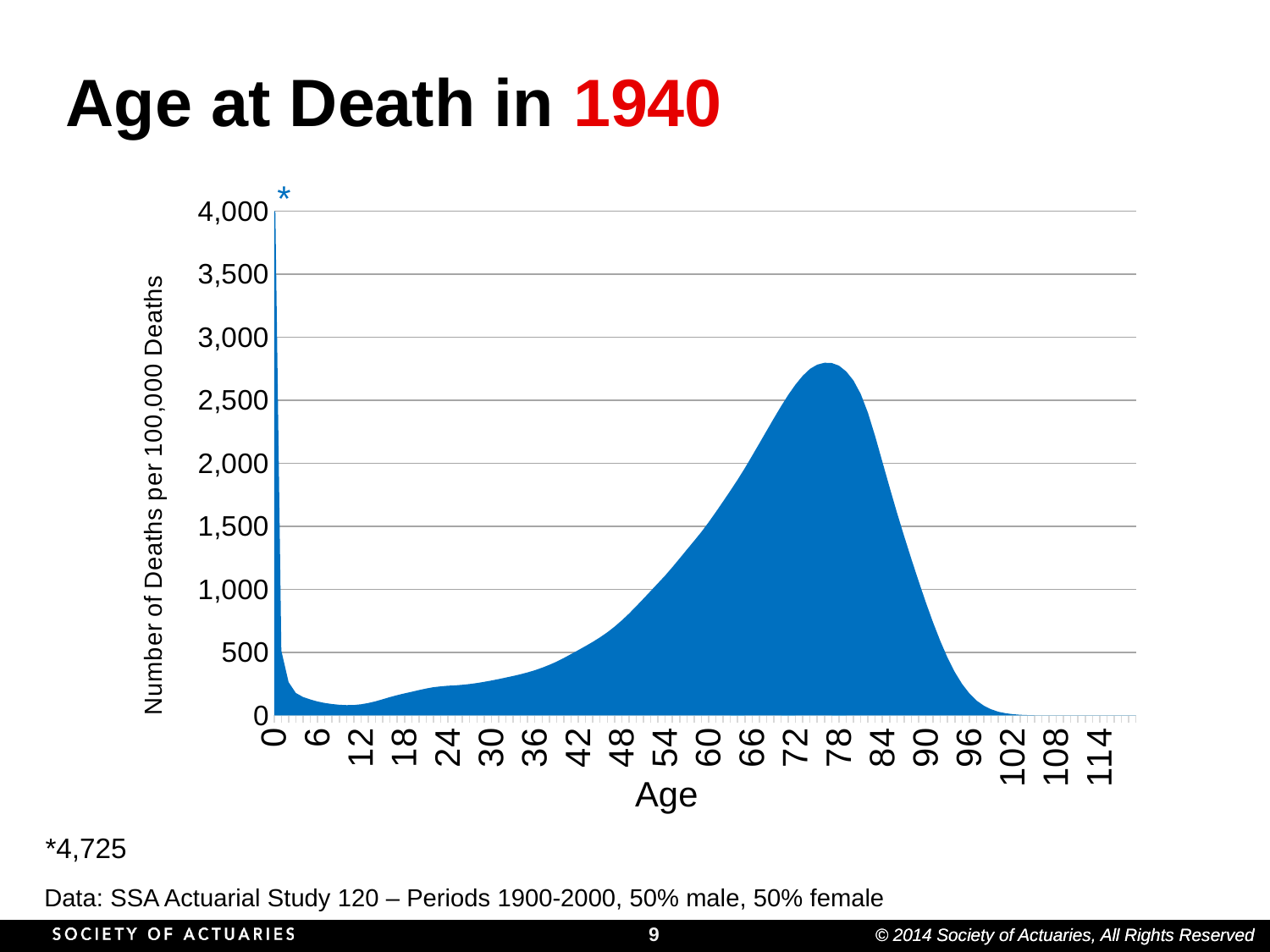
Is the value at age 72 greater or less than 2,000? greater What is the number of deaths per 100,000 deaths at age 0, as given by the asterisk footnote? 4,725 Do the values rise or fall as age increases from 78 to 102? Fall Is the value at age 60 greater or less than 1,000? greater Is the value at age 36 greater or less than 500? less Which age has a higher number of deaths per 100,000: age 24 or age 72? Age 72 What is the label of the vertical axis? Number of Deaths per 100,000 Deaths Do the values rise or fall as age increases from 12 to 72? Rise What kind of chart is shown on the slide? Area chart What is the title of the chart? Age at Death in 1940